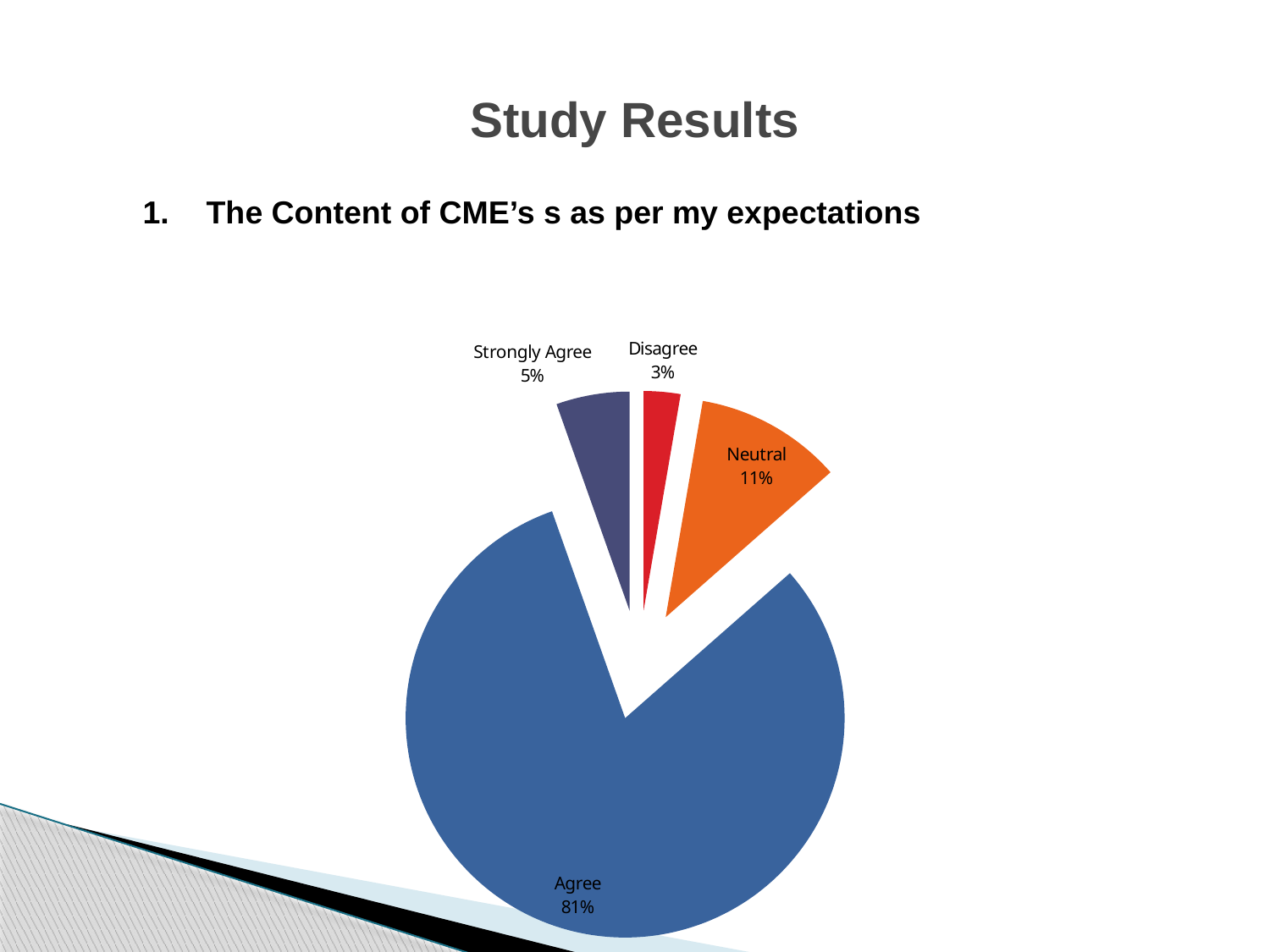
What share of the pie does Agree represent? 81% What share of the pie does Strongly Agree represent? 5% What share of the pie does Disagree represent? 3% Which is larger, the Neutral slice or the Strongly Agree slice? Neutral Which category has the largest slice of the pie? Agree What colour is the Neutral slice? orange What is the difference in percentage points between Agree and Neutral? 70 How many slices does the pie chart have? 4 What kind of chart is shown on the slide? pie chart Which category has the smallest slice of the pie? Disagree What is the difference in percentage points between Strongly Agree and Disagree? 2